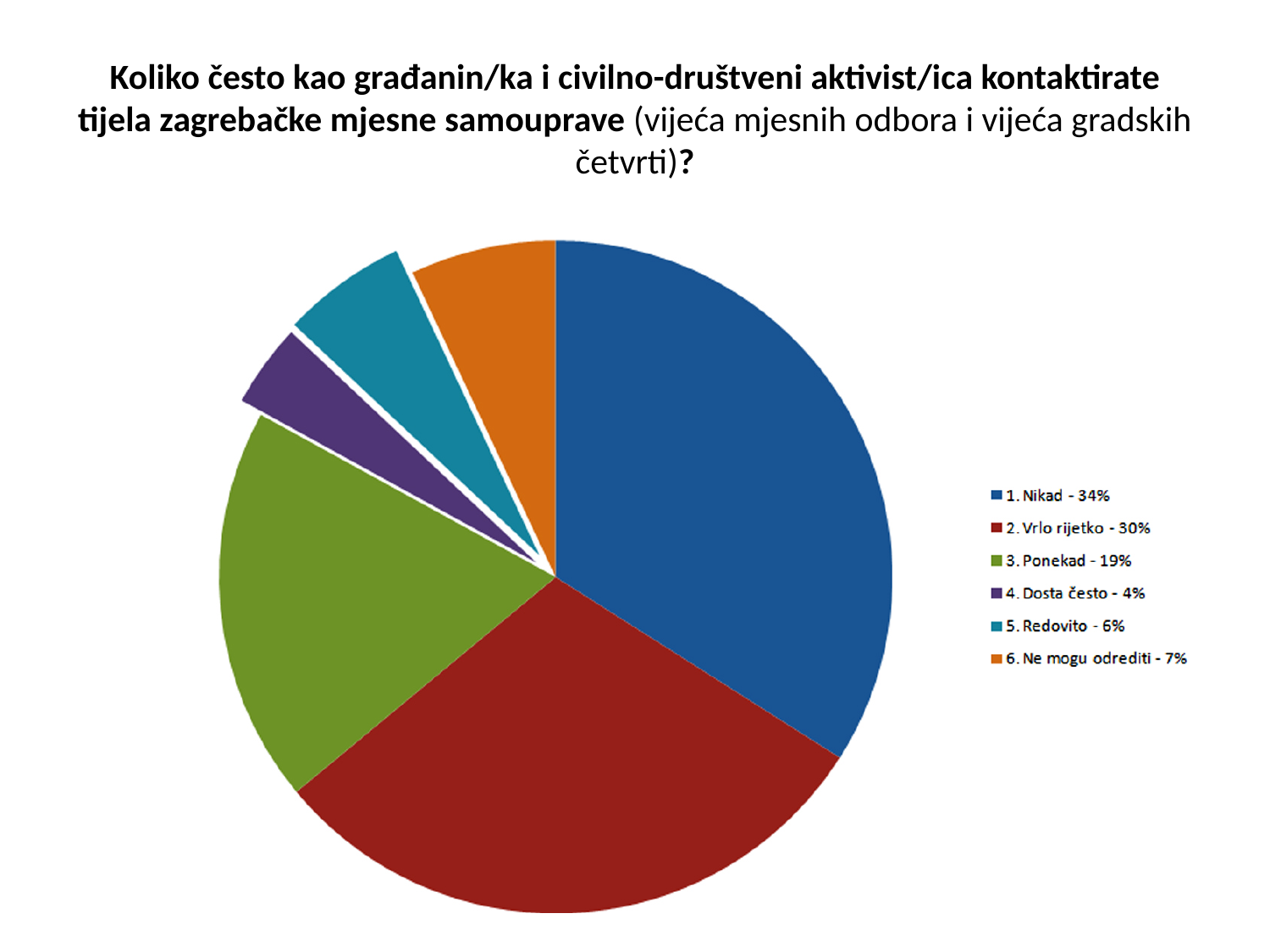
What share of the pie does "3. Ponekad" have? 19% What is the difference between the shares of "1. Nikad" and "2. Vrlo rijetko"? 4% Which category has the smallest share of the pie? 4. Dosta često What colour is the slice for "3. Ponekad"? green What is the value for "5. Redovito"? 6% What share of the pie does "1. Nikad" have? 34% Which category has the largest share of the pie? 1. Nikad Which is larger, the share for "5. Redovito" or for "6. Ne mogu odrediti"? 6. Ne mogu odrediti What kind of chart is shown on the slide? pie chart How many categories does the pie chart have? 6 What is the difference between the shares of "3. Ponekad" and "5. Redovito"? 13% What is the value for "6. Ne mogu odrediti"? 7%